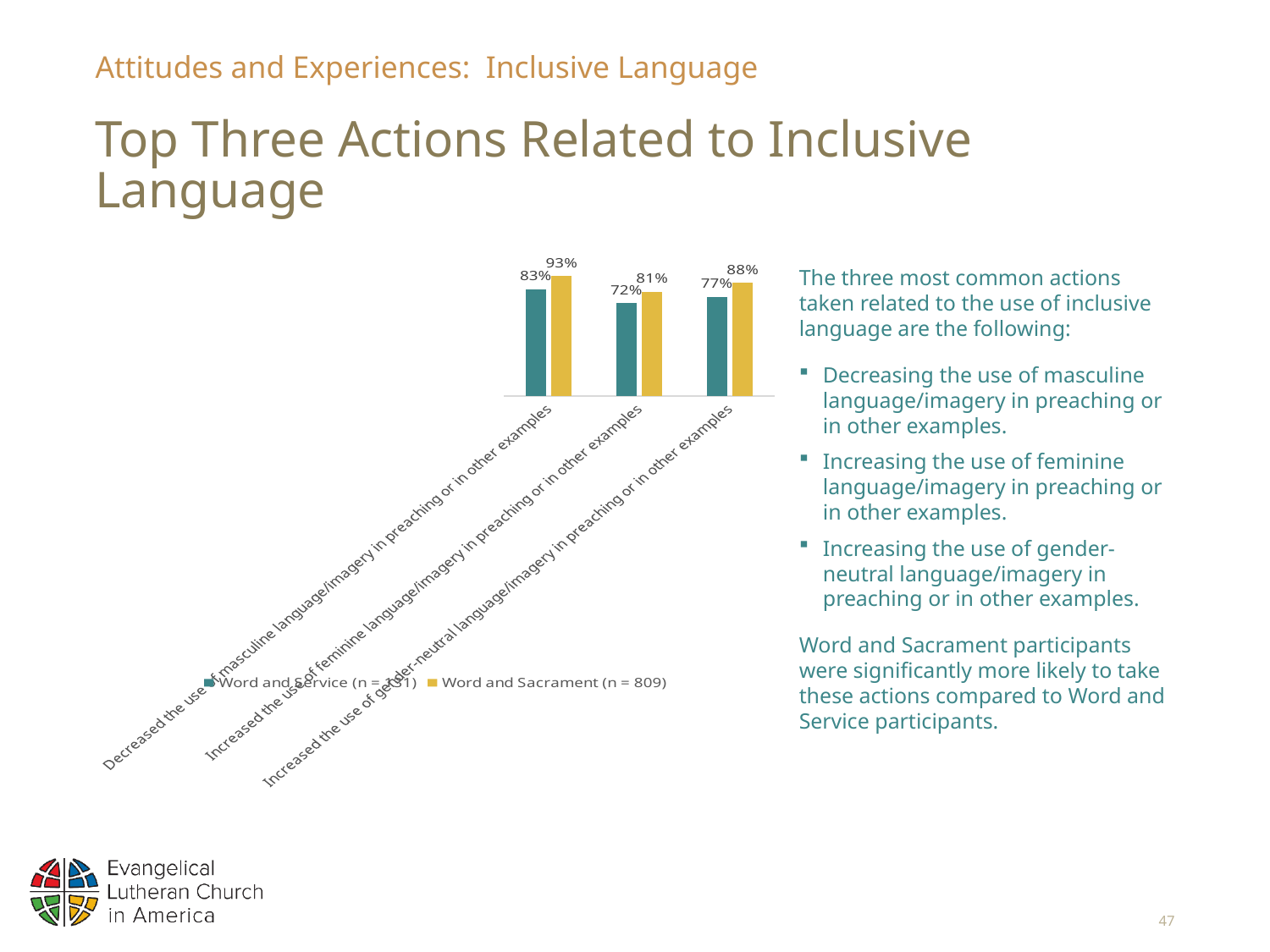
What percentage of Word and Service participants increased the use of feminine language/imagery in preaching or in other examples? 72% How many series does the chart legend list? 2 For increasing the use of gender-neutral language/imagery, which group has the larger value: Word and Service or Word and Sacrament? Word and Sacrament Which action has the highest Word and Sacrament percentage? Decreased the use of masculine language/imagery in preaching or in other examples What percentage of Word and Sacrament participants decreased the use of masculine language/imagery in preaching or in other examples? 93% What type of chart is shown on the slide? Bar chart What is the Word and Sacrament value for increasing the use of gender-neutral language/imagery in preaching or in other examples? 88% What is the difference between the Word and Sacrament and Word and Service values for decreasing the use of masculine language/imagery? 10 percentage points What is the difference between the Word and Sacrament and Word and Service values for increasing the use of feminine language/imagery? 9 percentage points How many actions (categories) are shown in the chart? 3 What is the Word and Service value for increasing the use of gender-neutral language/imagery in preaching or in other examples? 77% Which action has the lowest Word and Service percentage? Increased the use of feminine language/imagery in preaching or in other examples